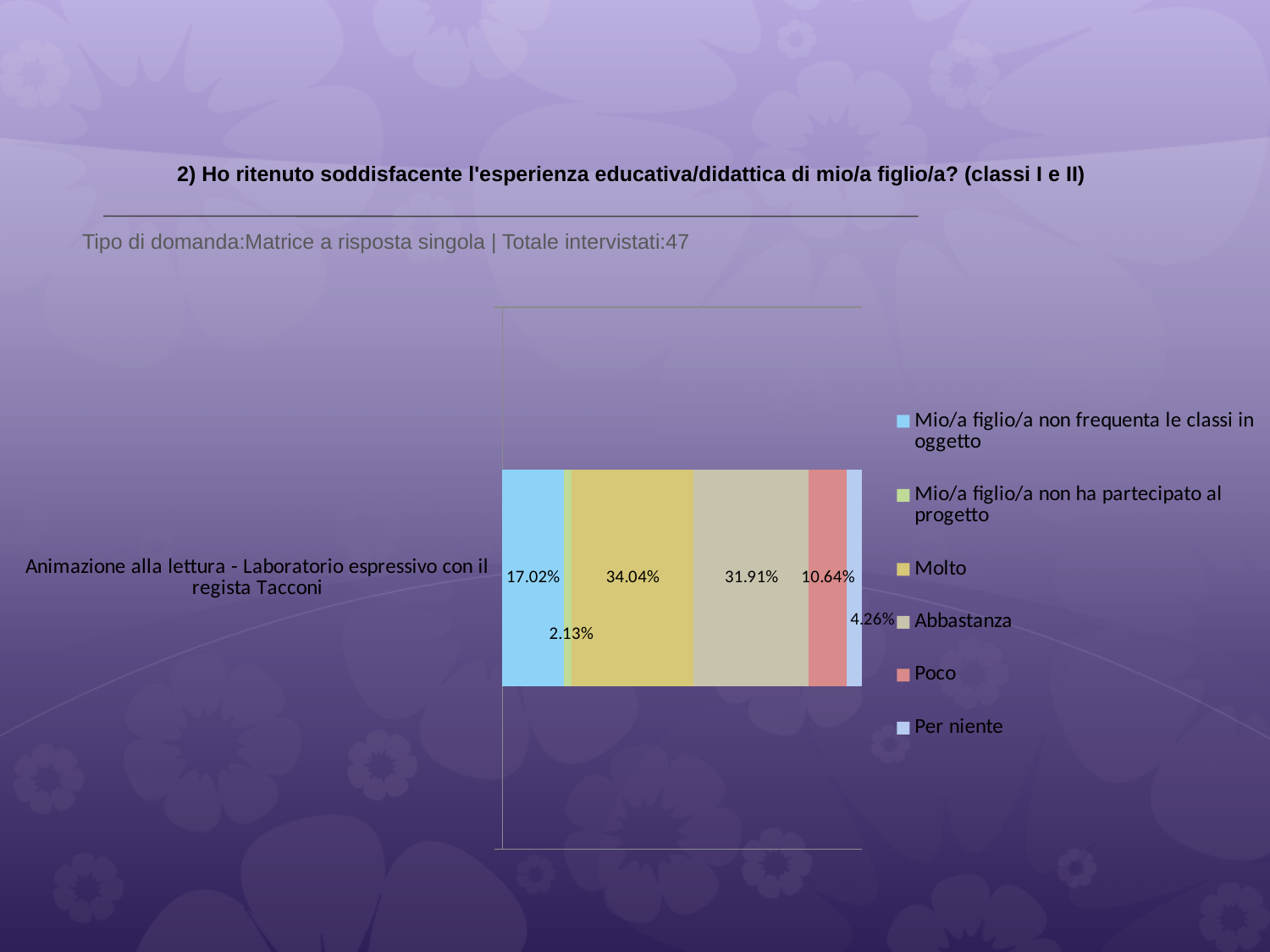
How many series does the legend list? 6 What type of chart is shown on the slide? Stacked bar chart What is the difference between the values for 'Molto' and 'Abbastanza'? 2.13% Which series has the highest value? Molto What is the value for 'Abbastanza'? 31.91% Which series has the lowest value? Mio/a figlio/a non ha partecipato al progetto How many categories are plotted on the chart? 1 What is the value for 'Per niente'? 4.26% Which is larger, the value for 'Poco' or the value for 'Per niente'? Poco What is the value for 'Mio/a figlio/a non frequenta le classi in oggetto'? 17.02% What is the value for 'Poco'? 10.64% What is the value for 'Molto'? 34.04%